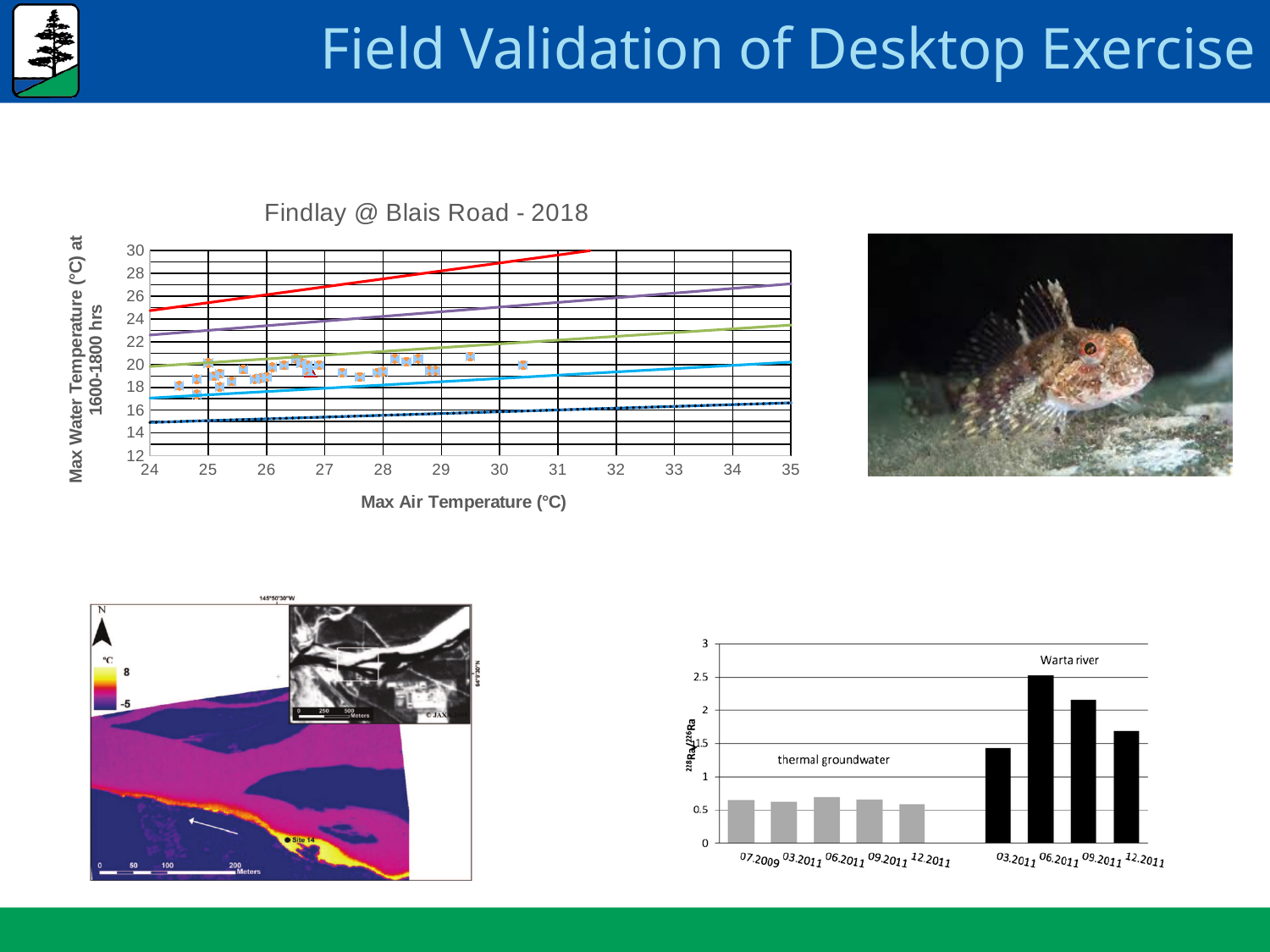
What is the title of the chart at the top left of the slide? Findlay @ Blais Road - 2018 In the bottom-right bar chart, is the value for Warta river 06.2011 greater or less than 2? greater In the bottom-right bar chart, is the value for thermal groundwater 07.2009 greater or less than 1? less In the 'Findlay @ Blais Road - 2018' chart, what is the highest value shown on the y axis? 30 In the 'Findlay @ Blais Road - 2018' chart, are all the plotted data points below 22 on the y axis? Yes In the bottom-right bar chart, how many bars are plotted in total? 9 What kind of chart is the one at the bottom right of the slide? Bar chart In the 'Findlay @ Blais Road - 2018' chart, what is the label of the x axis? Max Air Temperature (°C) In the bottom-right bar chart, how many bars belong to the 'Warta river' group? 4 In the bottom-right bar chart, which is larger: Warta river 06.2011 or Warta river 12.2011? Warta river 06.2011 In the bottom-right bar chart, which bar is the highest? Warta river 06.2011 In the 'Findlay @ Blais Road - 2018' chart, does the red line rise or fall as Max Air Temperature increases? Rises